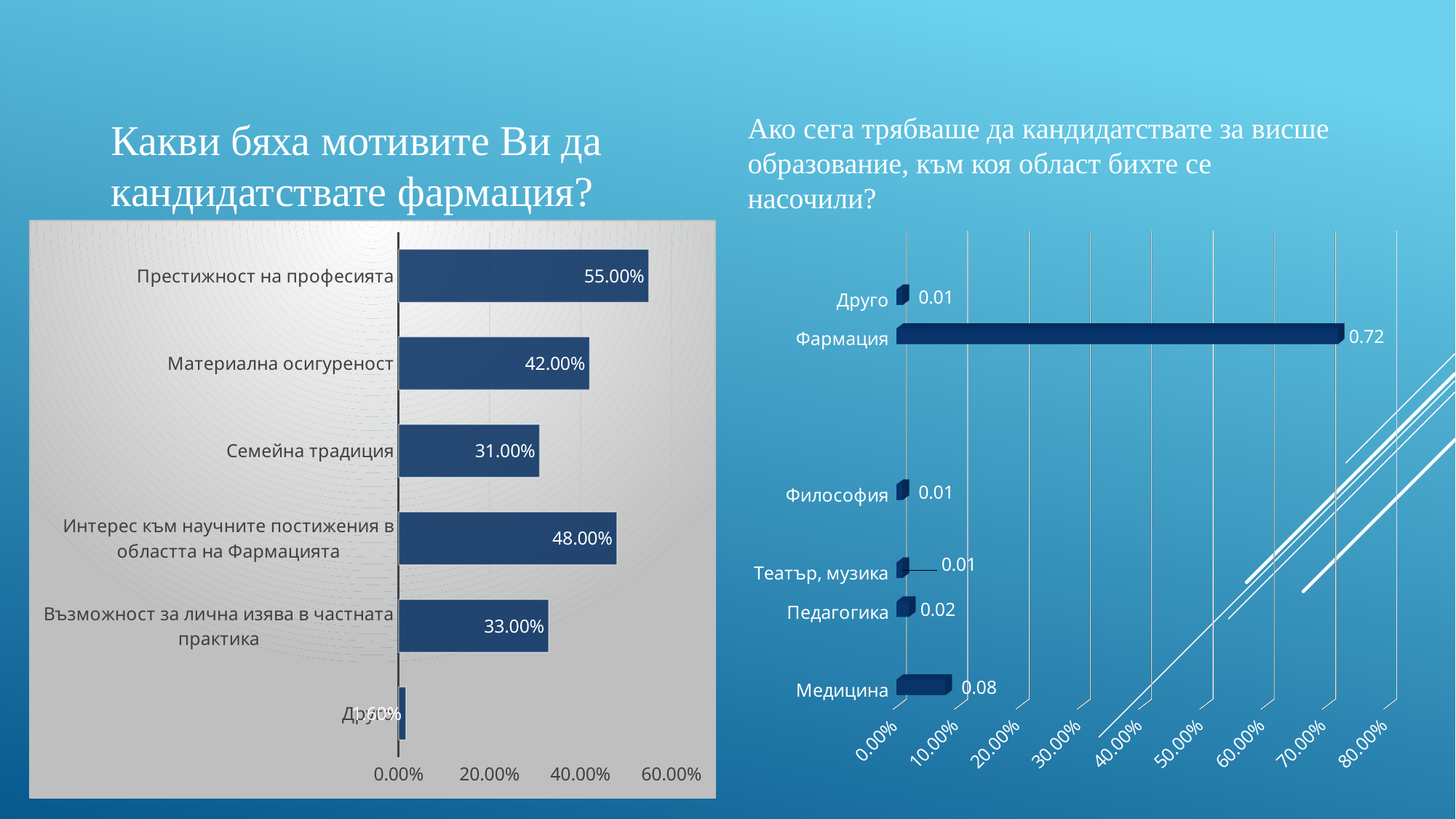
In the right chart ("Ако сега трябваше да кандидатствате за висше образование..."), what is the value for "Фармация"? 0.72 In the left chart, what is the value for "Интерес към научните постижения в областта на Фармацията"? 48.00% In the left chart, which is larger: "Материална осигуреност" or "Интерес към научните постижения в областта на Фармацията"? Интерес към научните постижения в областта на Фармацията How many categories are shown in the right chart? 6 In the right chart, what is the value for "Педагогика"? 0.02 In the left chart, what is the difference between "Материална осигуреност" and "Възможност за лична изява в частната практика"? 9.00% In the left chart, what is the value for "Семейна традиция"? 31.00% In the right chart, which category has the highest value? Фармация In the left chart ("Какви бяха мотивите Ви да кандидатствате фармация?"), what is the value for "Престижност на професията"? 55.00% In the left chart, which category has the highest value? Престижност на професията In the right chart, what is the value for "Медицина"? 0.08 What kind of chart is the left chart? Bar chart